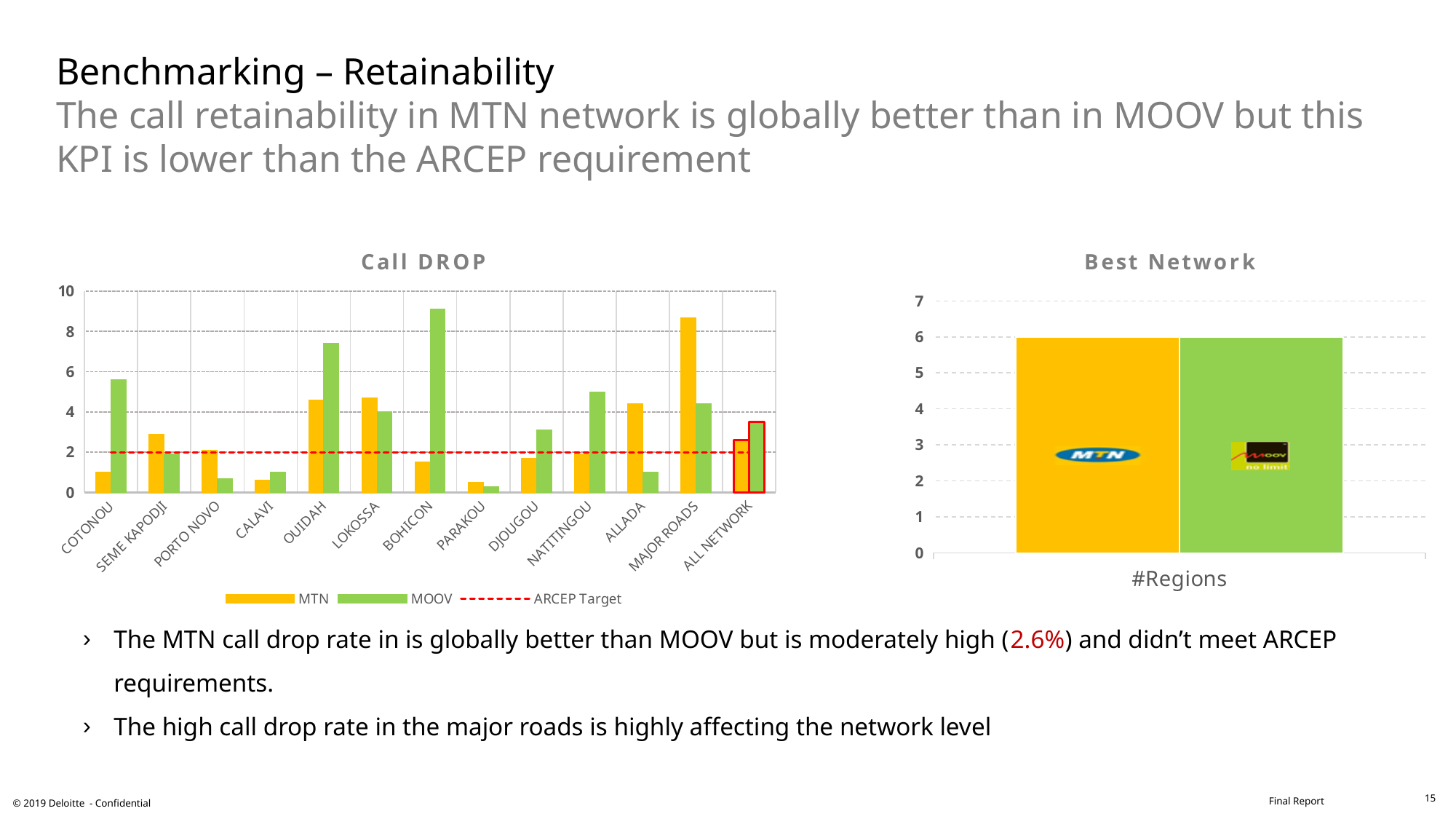
In the Call DROP chart, which category has the highest MTN value? MAJOR ROADS In the Call DROP chart, is the MOOV value for OUIDAH greater or less than 6? greater In the Call DROP chart, which is larger at COTONOU, the MTN value or the MOOV value? MOOV What kind of chart is the Call DROP chart? Combination bar and line chart In the Call DROP chart, is the MOOV value for BOHICON greater or less than 8? greater In the Call DROP chart, how many categories are shown on the x axis? 13 In the Call DROP chart, which is larger at MAJOR ROADS, the MTN value or the MOOV value? MTN In the Call DROP chart, what does the red dashed line represent according to the legend? ARCEP Target In the Best Network chart, what is the value for MTN? 6 How many entries does the legend of the Call DROP chart list? 3 In the Call DROP chart, which category has the highest MOOV value? BOHICON In the Call DROP chart, is the MTN value for COTONOU greater or less than 2? less